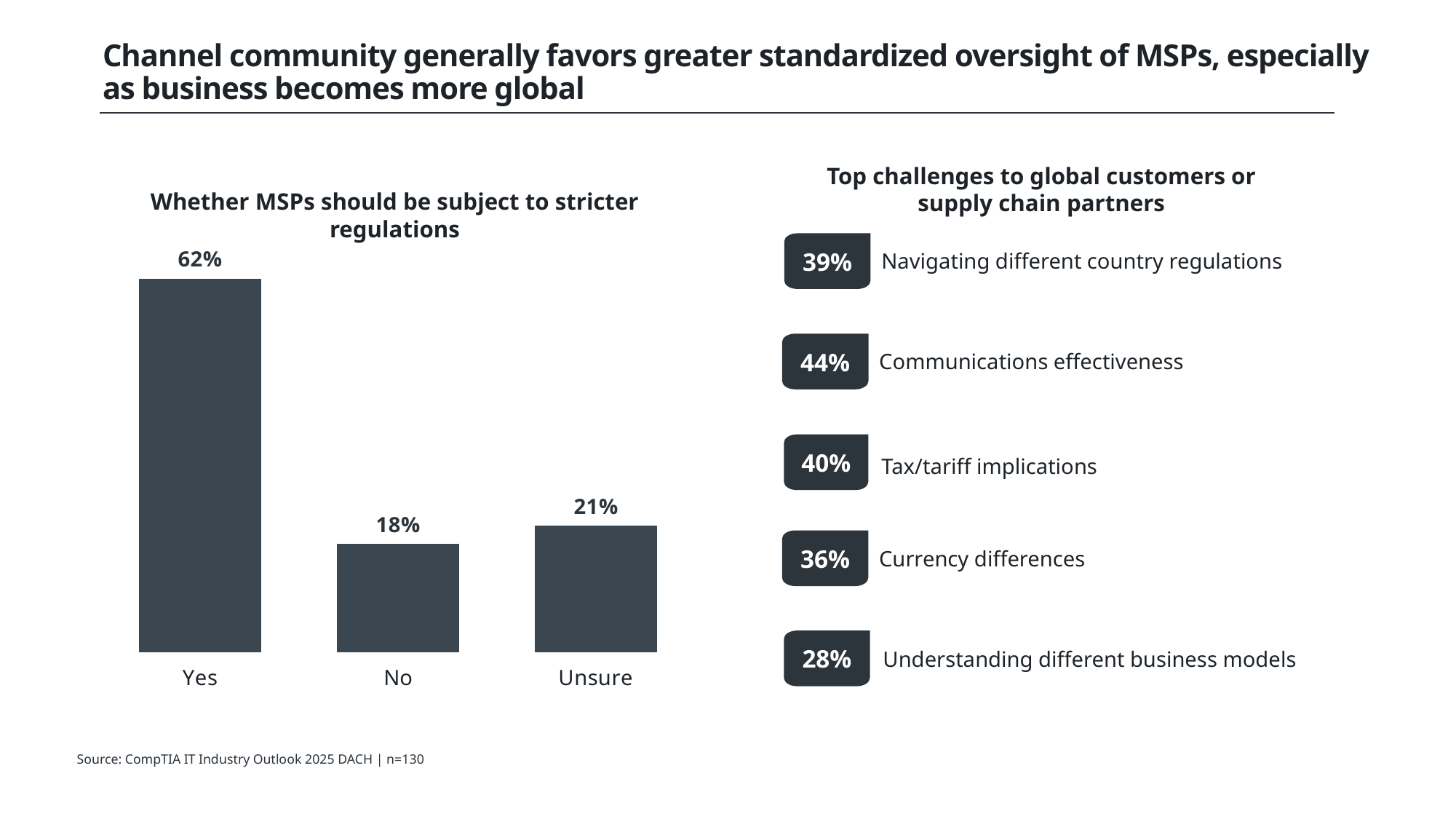
How many categories are shown in the chart 'Whether MSPs should be subject to stricter regulations'? 3 In the chart 'Whether MSPs should be subject to stricter regulations', what is the value for Unsure? 21% In the chart 'Whether MSPs should be subject to stricter regulations', which is larger, the value for Unsure or the value for No? Unsure In the 'Top challenges to global customers or supply chain partners' list, what is the value for Communications effectiveness? 44% In the chart 'Whether MSPs should be subject to stricter regulations', which category has the highest value? Yes In the chart 'Whether MSPs should be subject to stricter regulations', which category has the lowest value? No What kind of chart is 'Whether MSPs should be subject to stricter regulations'? Bar chart In the 'Top challenges to global customers or supply chain partners' list, what is the difference between Tax/tariff implications and Currency differences? 4% In the 'Top challenges to global customers or supply chain partners' list, which challenge has the lowest value? Understanding different business models In the chart 'Whether MSPs should be subject to stricter regulations', what is the value for Yes? 62% In the chart 'Whether MSPs should be subject to stricter regulations', what is the difference between the values for Yes and No? 44% In the chart 'Whether MSPs should be subject to stricter regulations', what is the value for No? 18%